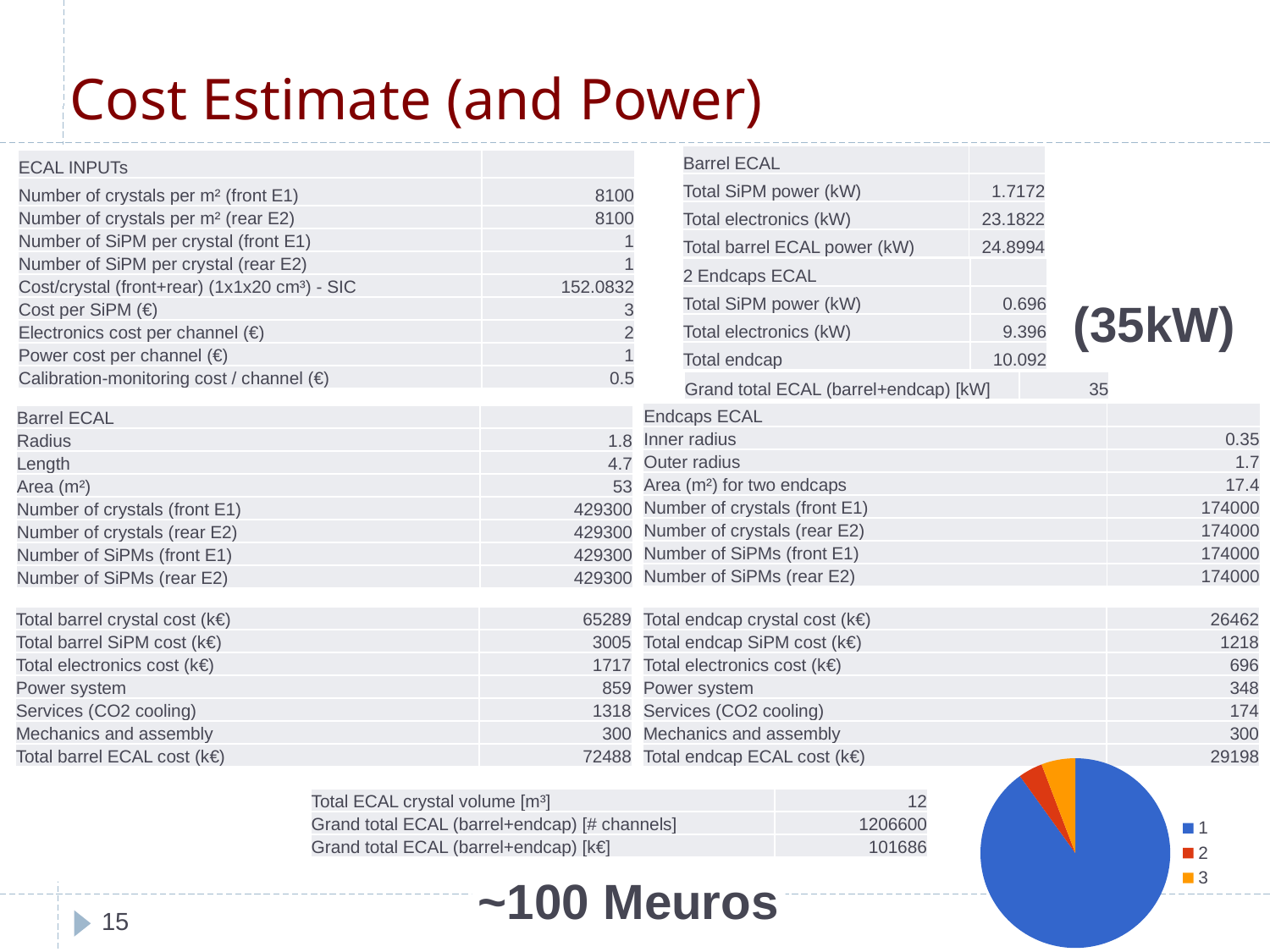
In the pie chart, which is larger: slice 3 or slice 1? 1 What colour is slice 1 in the pie chart? blue How many entries does the legend of the pie chart list? 3 What kind of chart is shown at the bottom right of the slide? pie chart What are the legend entries of the pie chart? 1, 2, 3 In the pie chart, which is larger: slice 1 or slice 2? 1 Which slice of the pie chart is the largest? 1 How many slices does the pie chart at the bottom right have? 3